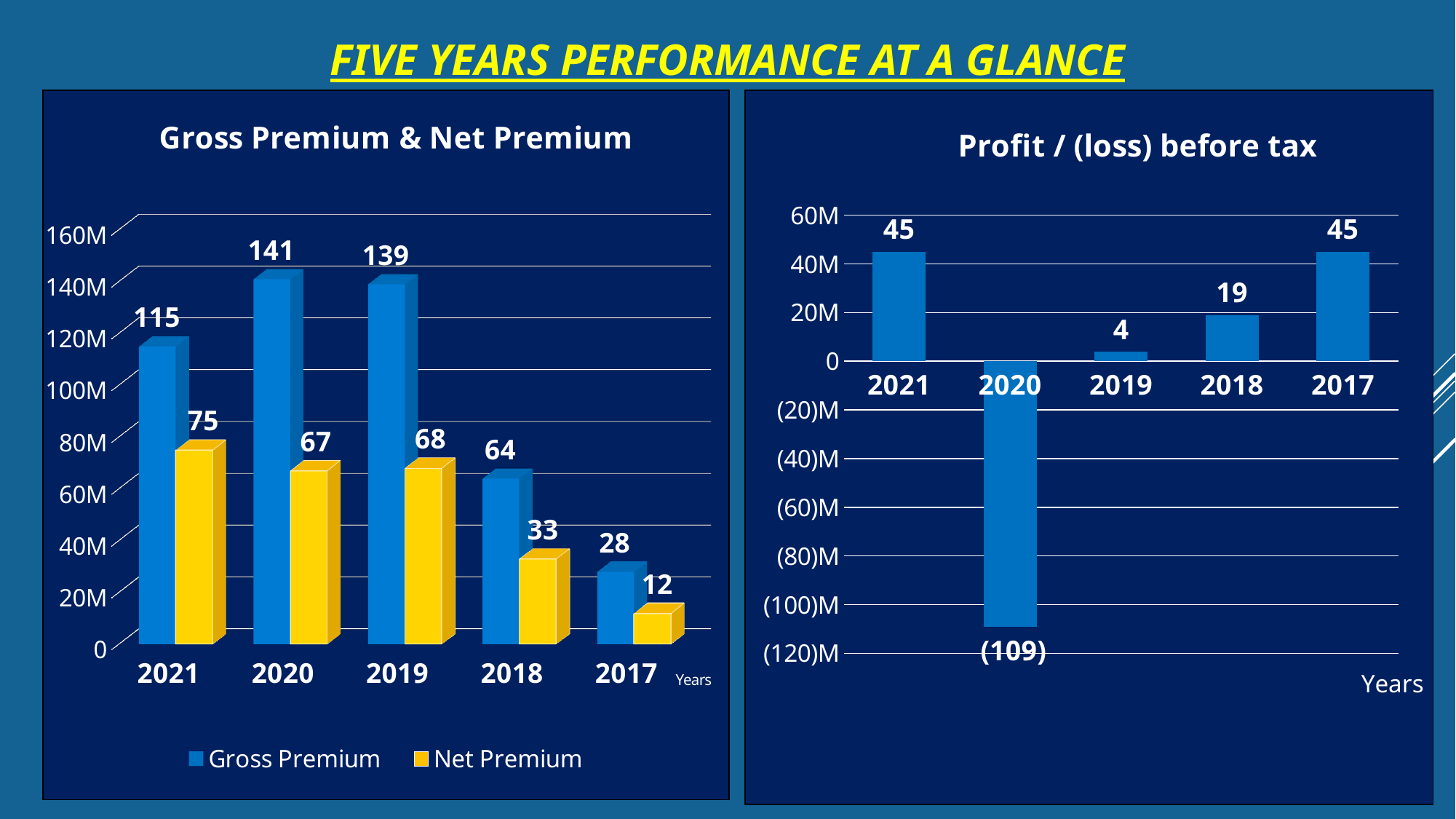
In the 'Profit / (loss) before tax' chart, how many years are shown? 5 In the 'Gross Premium & Net Premium' chart, what is the Gross Premium value for 2020? 141 In the 'Gross Premium & Net Premium' chart, what is the Net Premium value for 2018? 33 What kind of chart is the 'Profit / (loss) before tax' chart? Bar chart In the 'Gross Premium & Net Premium' chart, which year has the lowest Net Premium? 2017 In the 'Gross Premium & Net Premium' chart, which colour represents Net Premium? Yellow In the 'Gross Premium & Net Premium' chart, how many series does the legend list? 2 In the 'Gross Premium & Net Premium' chart, which year has the highest Gross Premium? 2020 In the 'Profit / (loss) before tax' chart, which year has the lowest value? 2020 In the 'Profit / (loss) before tax' chart, what is the value for 2018? 19 In the 'Gross Premium & Net Premium' chart, what is the difference between Gross Premium and Net Premium in 2021? 40 In the 'Profit / (loss) before tax' chart, what is the value for 2020? (109)